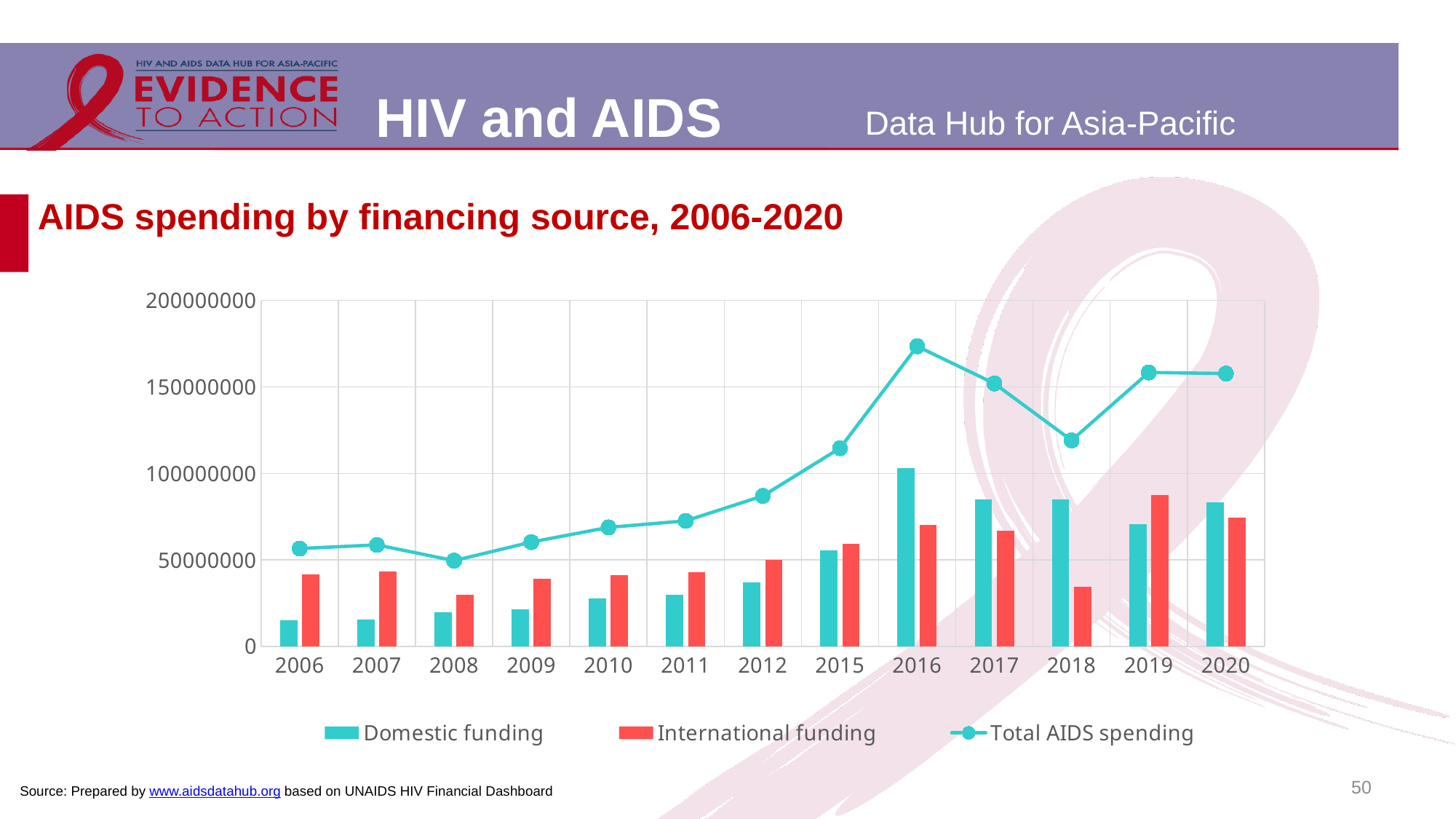
How many series does the legend list? 3 Is Domestic funding in 2006 greater or less than 50000000? less What kind of chart is shown on the slide? Bar and line chart In 2006, which is larger: Domestic funding or International funding? International funding In which year is International funding highest? 2019 In which year is Total AIDS spending lowest? 2008 In 2018, which is larger: Domestic funding or International funding? Domestic funding In which year is Total AIDS spending highest? 2016 Is Total AIDS spending in 2018 greater or less than 100000000? greater How many years are shown on the x axis? 13 In which year is Domestic funding highest? 2016 Is Total AIDS spending in 2016 greater or less than 150000000? greater